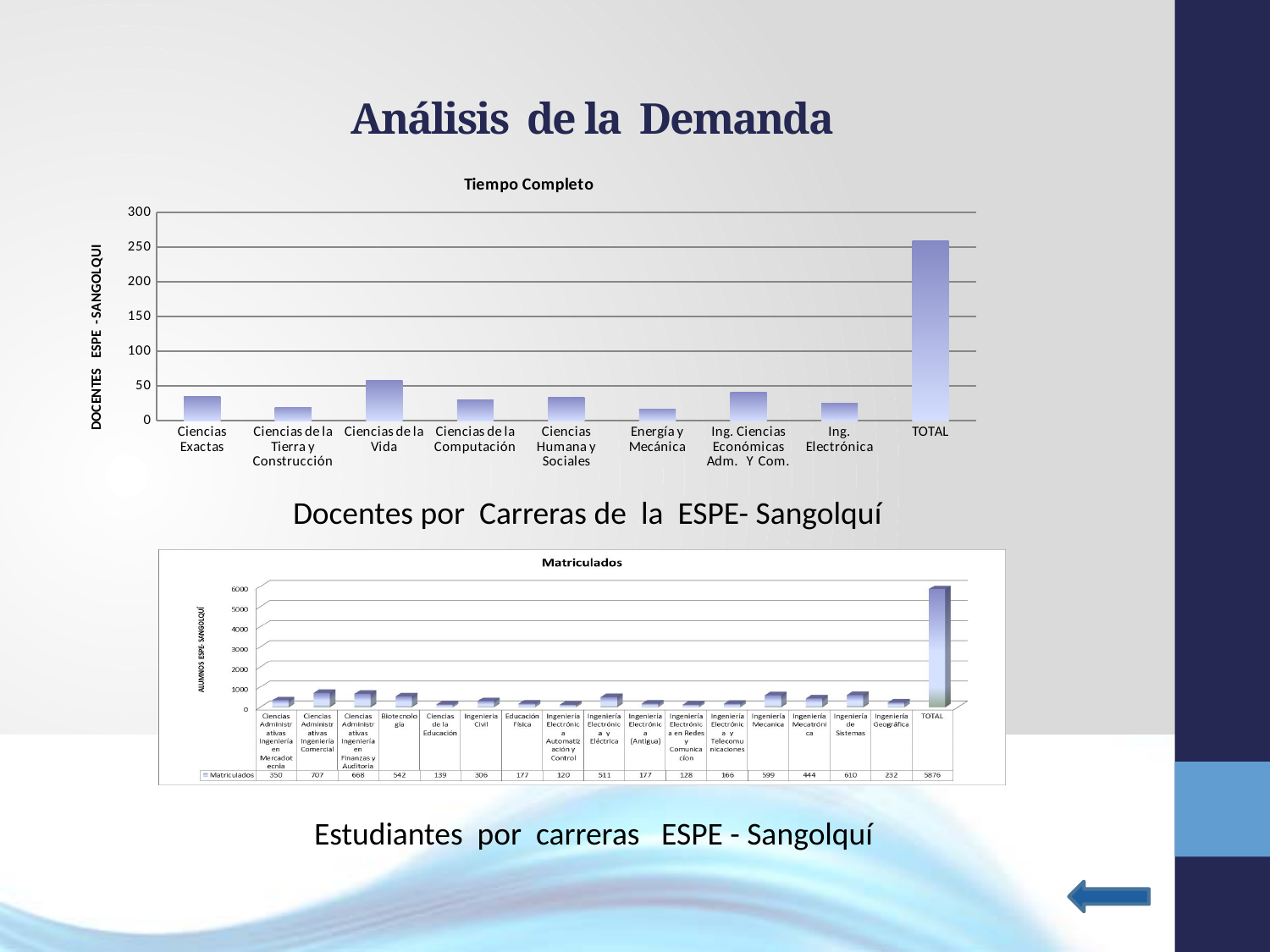
In the 'Tiempo Completo' chart, which category other than TOTAL has the highest bar? Ciencias de la Vida In the 'Matriculados' chart, what is the value for Biotecnología? 542 In the 'Tiempo Completo' chart, how many categories are shown on the x axis? 9 In the 'Matriculados' chart, which career has the lowest number of students? Ingeniería Electrónica Automatización y Control In the 'Tiempo Completo' chart, is the value for Ciencias de la Vida greater or less than 50? greater What type of chart is the 'Tiempo Completo' chart? bar chart In the 'Matriculados' chart, which is larger: Ingeniería Civil or Ingeniería Mecatrónica? Ingeniería Mecatrónica In the 'Matriculados' chart, which career (excluding TOTAL) has the highest number of students? Ciencias Administrativas Ingeniería Comercial In the 'Matriculados' chart, what is the difference between Ingeniería de Sistemas and Ingeniería Mecánica? 11 In the 'Tiempo Completo' chart, is the value for TOTAL greater or less than 250? greater In the 'Matriculados' chart, what is the value for TOTAL? 5876 In the 'Tiempo Completo' chart, which category has the lowest bar? Energía y Mecánica